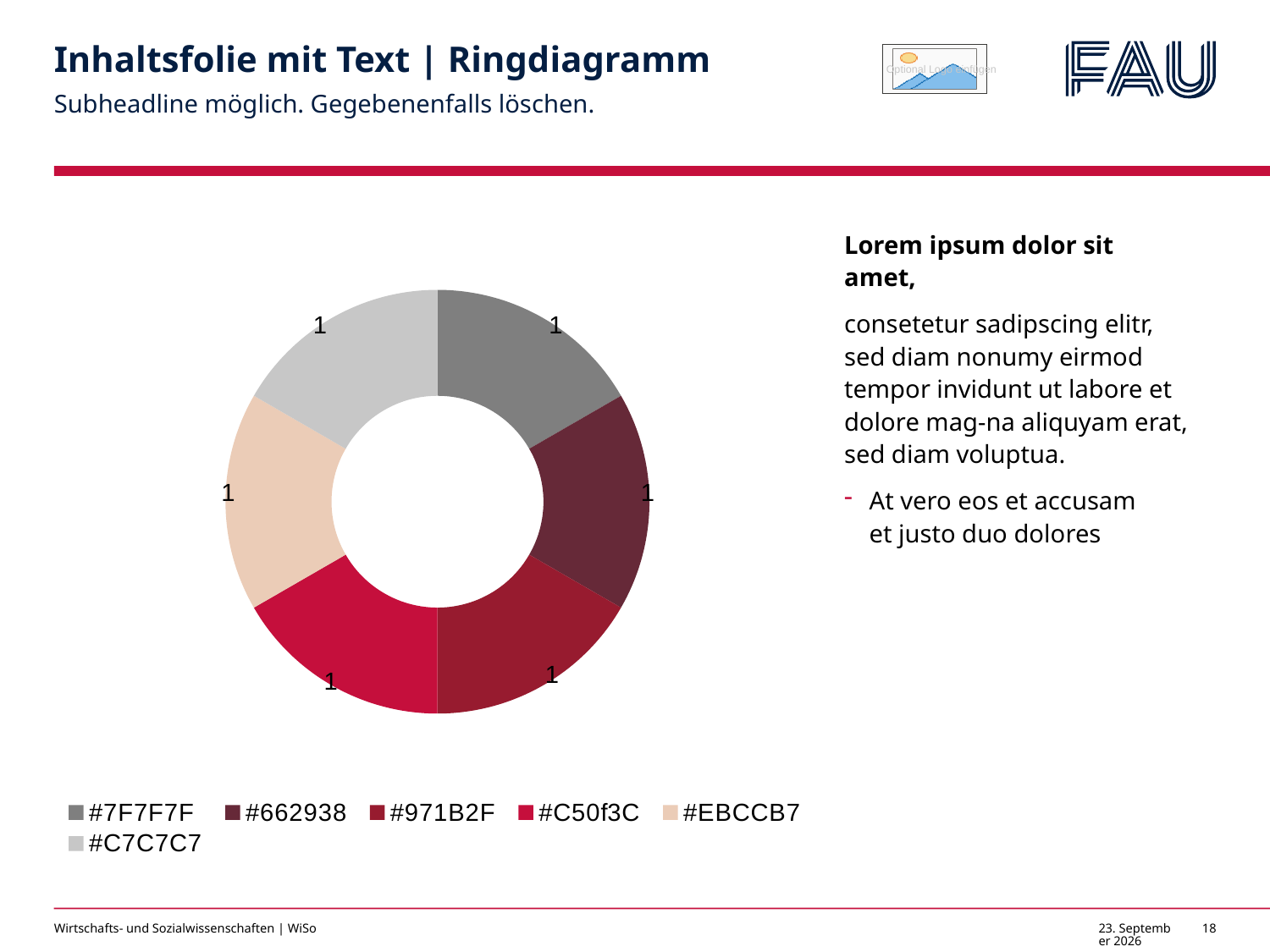
What is the total of all slice values in the doughnut chart? 6 What is the value of the #C7C7C7 slice in the doughnut chart? 1 What is the value of the #662938 slice in the doughnut chart? 1 What kind of chart is shown on the slide? doughnut chart What is the value of the #C50f3C slice in the doughnut chart? 1 What is the value of the #7F7F7F slice in the doughnut chart? 1 What is the value of the #971B2F slice in the doughnut chart? 1 What is the difference between the values of the #7F7F7F slice and the #C7C7C7 slice? 0 How many entries does the legend of the doughnut chart list? 6 Which legend entry is listed first in the doughnut chart's legend? #7F7F7F How many slices does the doughnut chart have? 6 What is the value of the #EBCCB7 slice in the doughnut chart? 1